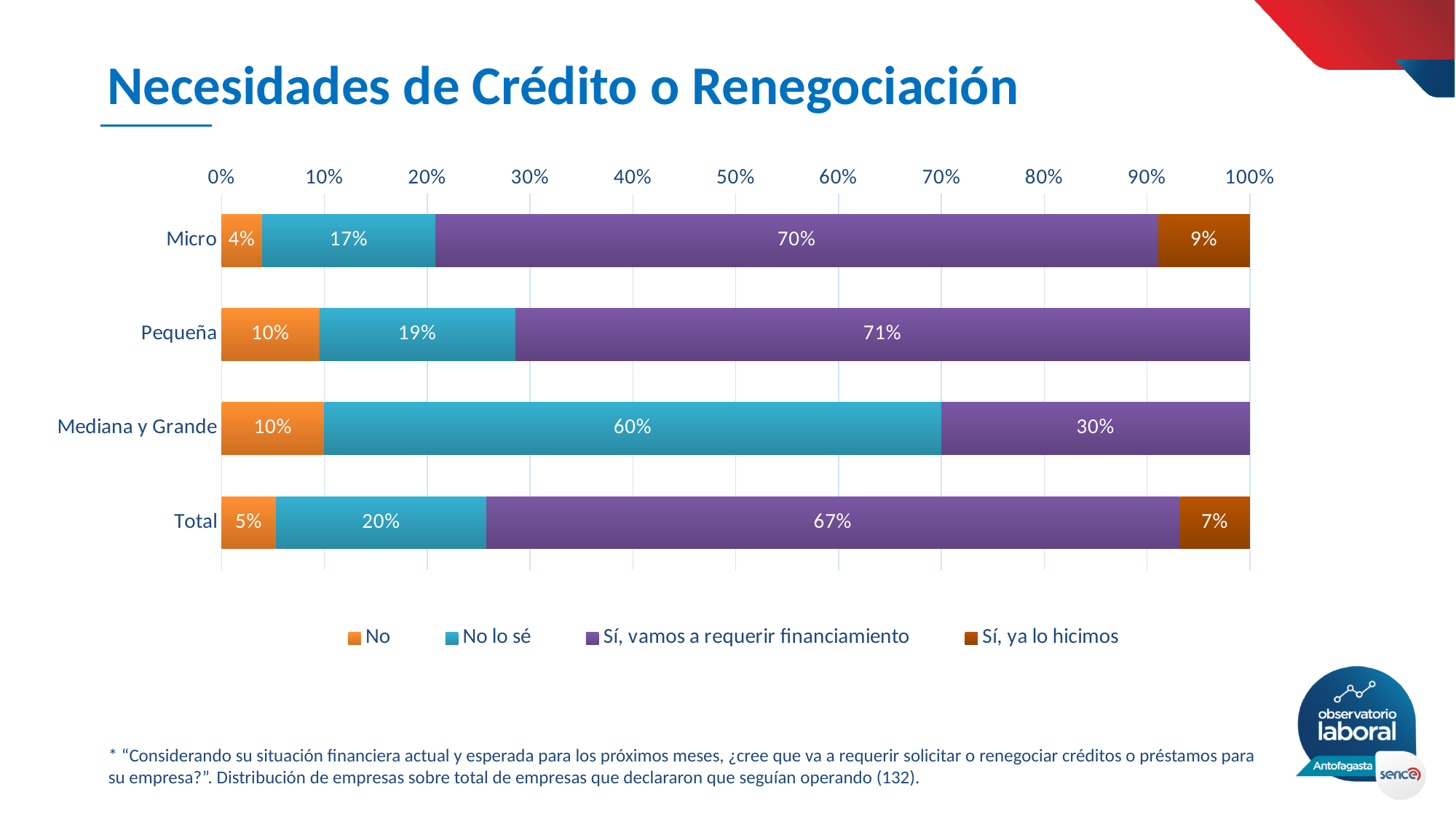
What is the value for "No" in the Pequeña category? 10% Which is larger: the "Sí, ya lo hicimos" value for Micro or for Total? Micro What is the difference between the "No lo sé" values for Mediana y Grande and Micro? 43 percentage points What kind of chart is shown on the slide? Stacked bar chart How many categories are shown on the y axis? 4 What is the value for "No lo sé" in the Mediana y Grande category? 60% What percentage of Micro companies answered "Sí, vamos a requerir financiamiento"? 70% Which category has the highest value for "Sí, vamos a requerir financiamiento"? Pequeña How many series does the legend list? 4 Which category has the lowest value for "No"? Micro What percentage of the Total answered "Sí, ya lo hicimos"? 7% What colour represents the "No lo sé" series? Teal/light blue